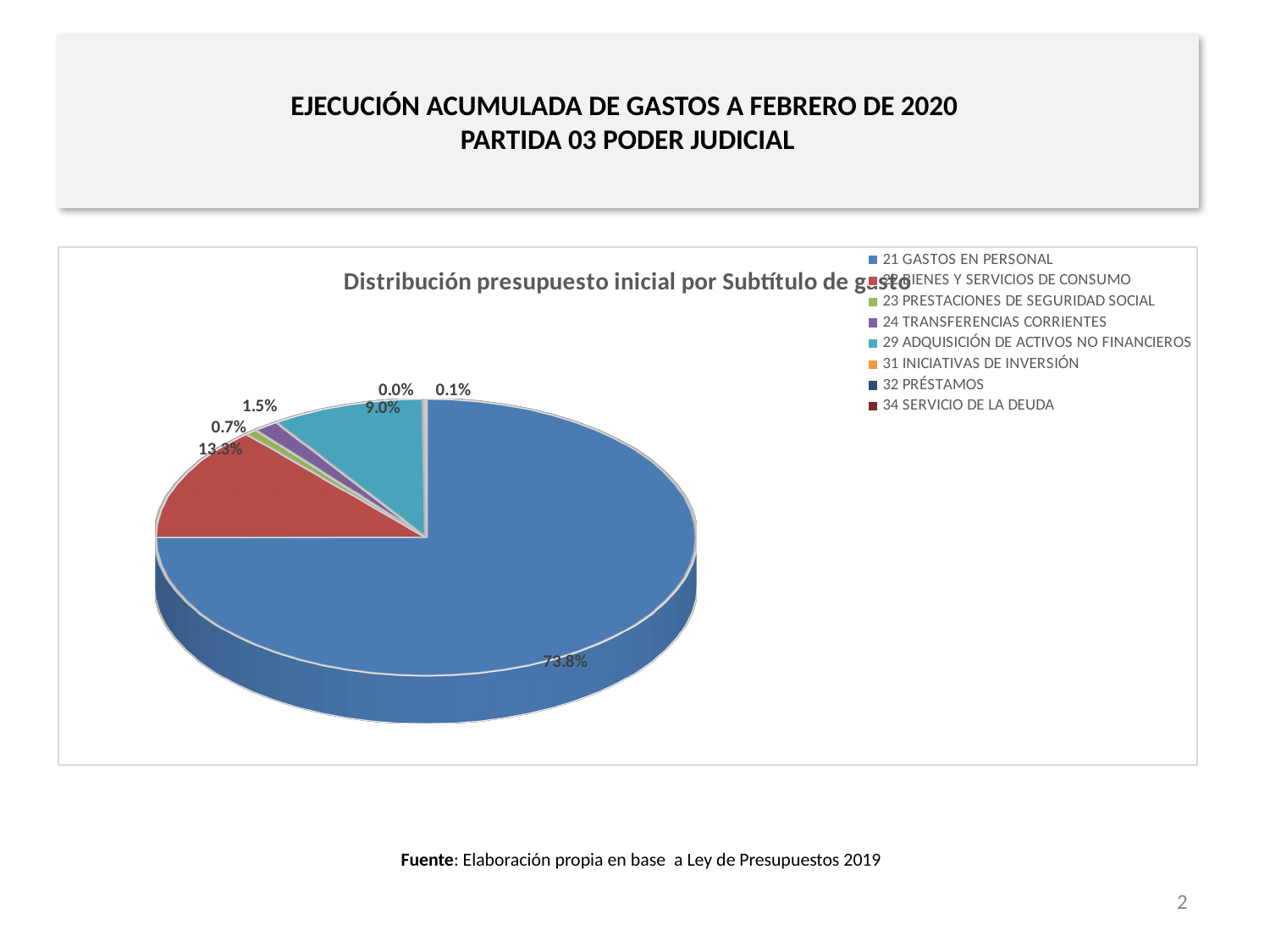
Which has a larger share: 29 ADQUISICIÓN DE ACTIVOS NO FINANCIEROS or 24 TRANSFERENCIAS CORRIENTES? 29 ADQUISICIÓN DE ACTIVOS NO FINANCIEROS What kind of chart is shown on the slide? Pie chart What is the title of the chart? Distribución presupuesto inicial por Subtítulo de gasto What is the difference in percentage points between 29 ADQUISICIÓN DE ACTIVOS NO FINANCIEROS and 24 TRANSFERENCIAS CORRIENTES? 7.5 percentage points What share of the pie does 24 TRANSFERENCIAS CORRIENTES have? 1.5% Which category has the largest slice of the pie? 21 GASTOS EN PERSONAL What share of the pie does 21 GASTOS EN PERSONAL have? 73.8% What share of the pie does 22 BIENES Y SERVICIOS DE CONSUMO have? 13.3% What share of the pie does 23 PRESTACIONES DE SEGURIDAD SOCIAL have? 0.7% How many categories does the legend list? 8 What is the difference in percentage points between 21 GASTOS EN PERSONAL and 22 BIENES Y SERVICIOS DE CONSUMO? 60.5 percentage points What share of the pie does 29 ADQUISICIÓN DE ACTIVOS NO FINANCIEROS have? 9.0%